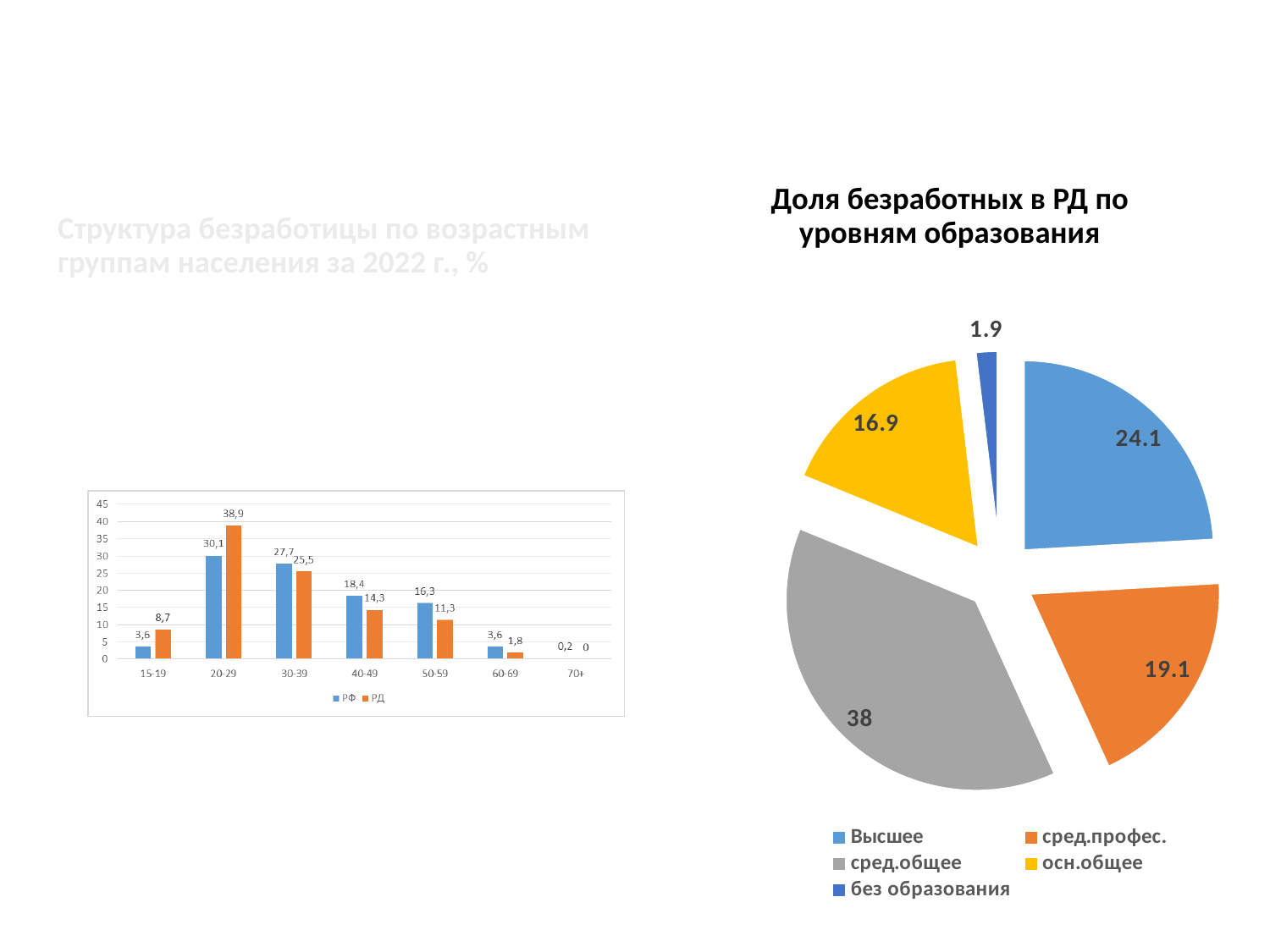
In the pie chart 'Доля безработных в РД по уровням образования', which category has the smallest slice? без образования What kind of chart is shown on the right side of the slide? pie chart In the bar chart on the left, what is the value for РД in the 20-29 age group? 38,9 In the bar chart on the left, which age group has the lowest value for РФ? 70+ In the bar chart on the left, which age group has the highest value for РД? 20-29 In the bar chart on the left, how many age groups are shown on the x axis? 7 In the bar chart on the left, how many series does the legend list? 2 In the pie chart 'Доля безработных в РД по уровням образования', what is the value for сред.общее? 38 In the bar chart on the left, what is the difference between РФ and РД in the 15-19 age group? 5,1 In the bar chart on the left, what is the value for РФ in the 40-49 age group? 18,4 In the pie chart 'Доля безработных в РД по уровням образования', what is the difference between Высшее and сред.профес.? 5 In the bar chart on the left, which is larger in the 30-39 age group, РФ or РД? РФ